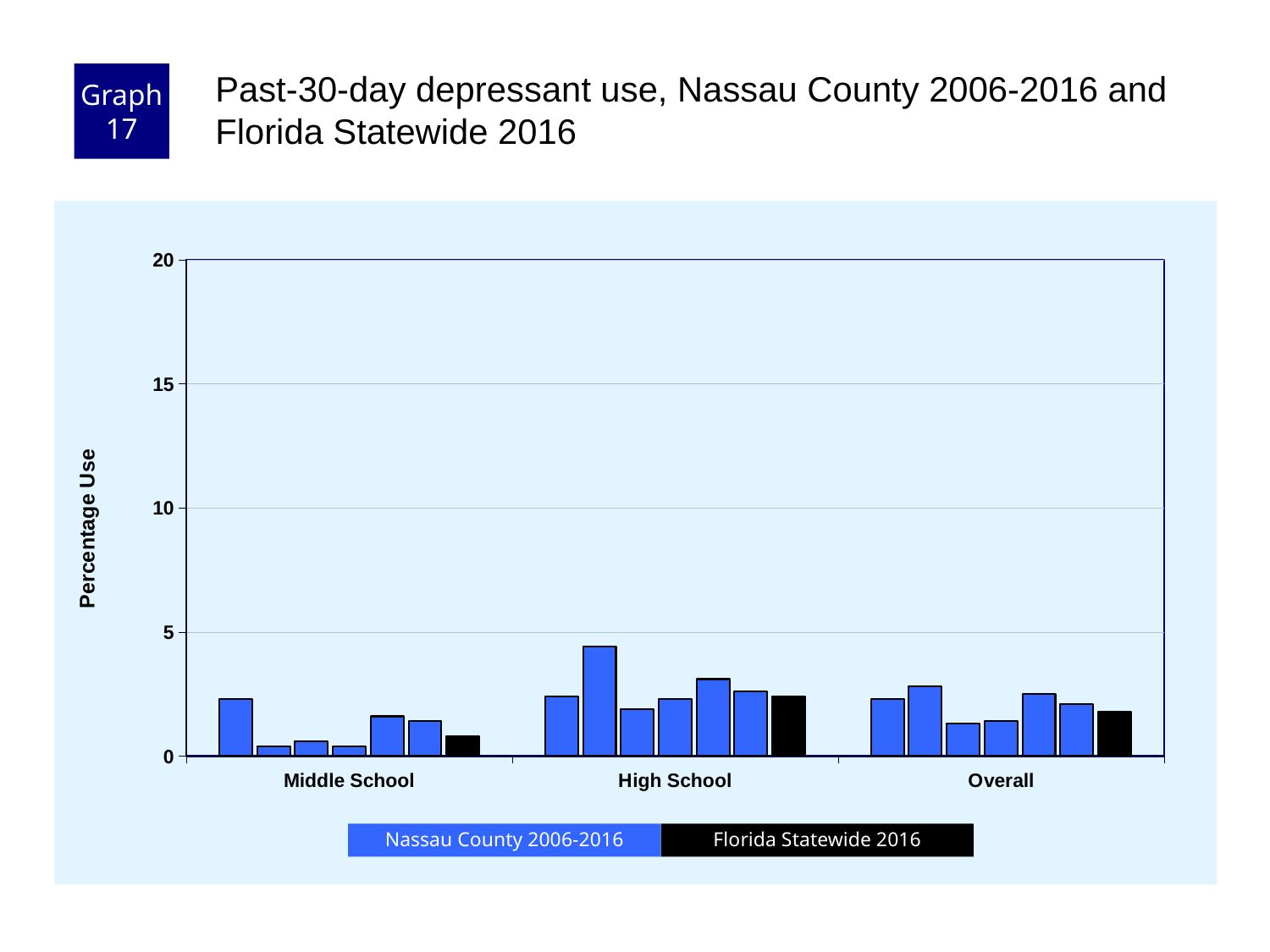
Which series is shown in black in the legend? Florida Statewide 2016 How many categories are shown on the x axis? 3 How many series does the legend list? 2 Which has the larger Florida Statewide 2016 value, Middle School or High School? High School Is the tallest Nassau County bar for High School greater or less than 5? less Which category has the lowest Florida Statewide 2016 value? Middle School Which category contains the tallest bar in the chart? High School Which has the larger Florida Statewide 2016 value, Middle School or Overall? Overall Is the Florida Statewide 2016 value for Middle School greater or less than 5? less What is the label on the y axis? Percentage Use Is the Florida Statewide 2016 value for High School greater or less than 5? less What kind of chart is shown on the slide? Bar chart